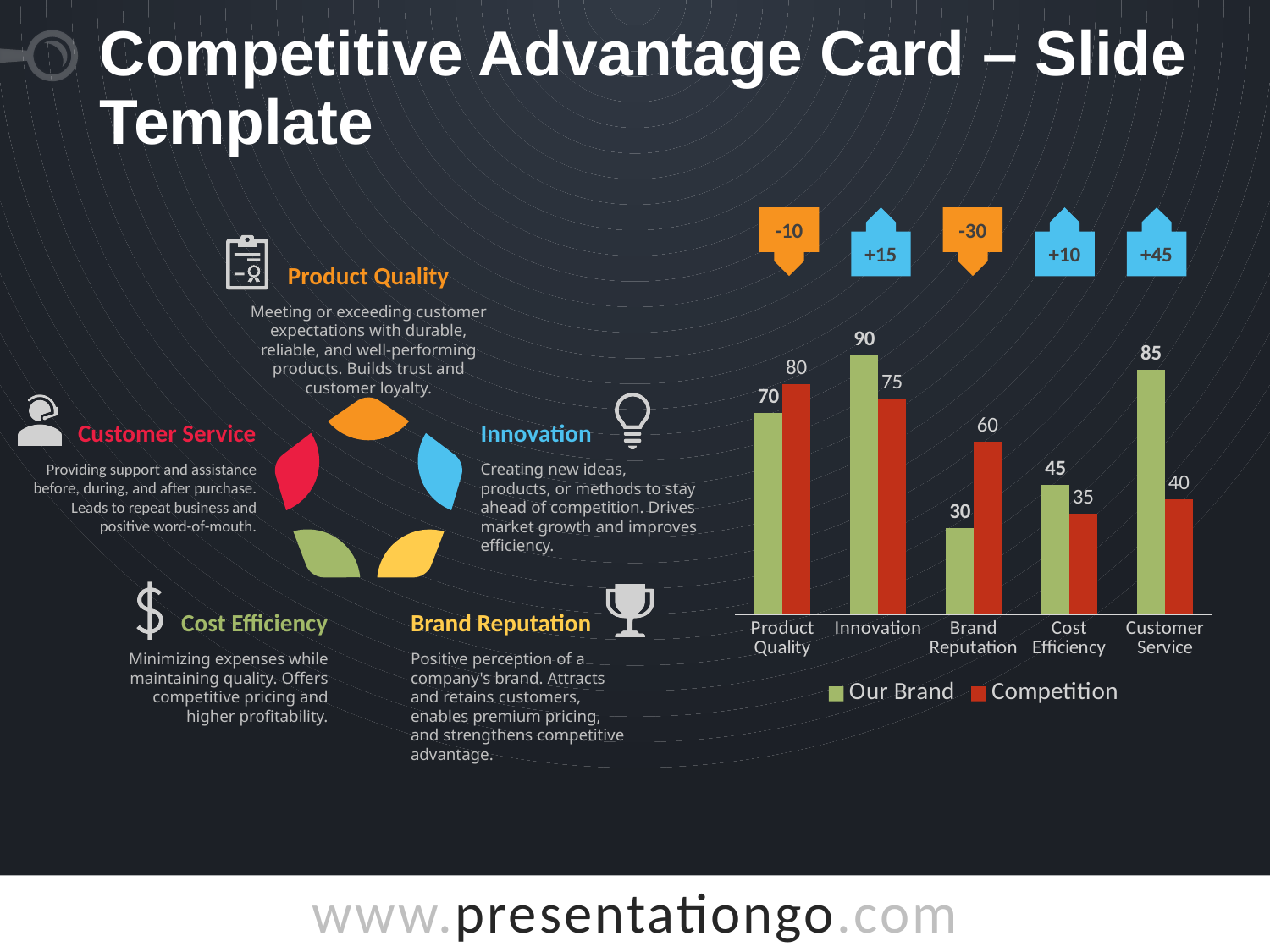
What is the value for Our Brand in the Customer Service category? 85 Which category has the lowest value for Competition? Cost Efficiency What is the value for Our Brand in the Innovation category? 90 What is the difference between Our Brand and Competition in the Brand Reputation category? 30 Which category has the highest value for Our Brand? Innovation How many categories are shown on the x axis of the chart? 5 What are the two series named in the chart legend? Our Brand and Competition What kind of chart is shown on the slide? Bar chart How many series does the chart legend list? 2 What is the difference between Our Brand and Competition in the Customer Service category? 45 What is the value for Competition in the Brand Reputation category? 60 Which is larger in the Product Quality category, Our Brand or Competition? Competition